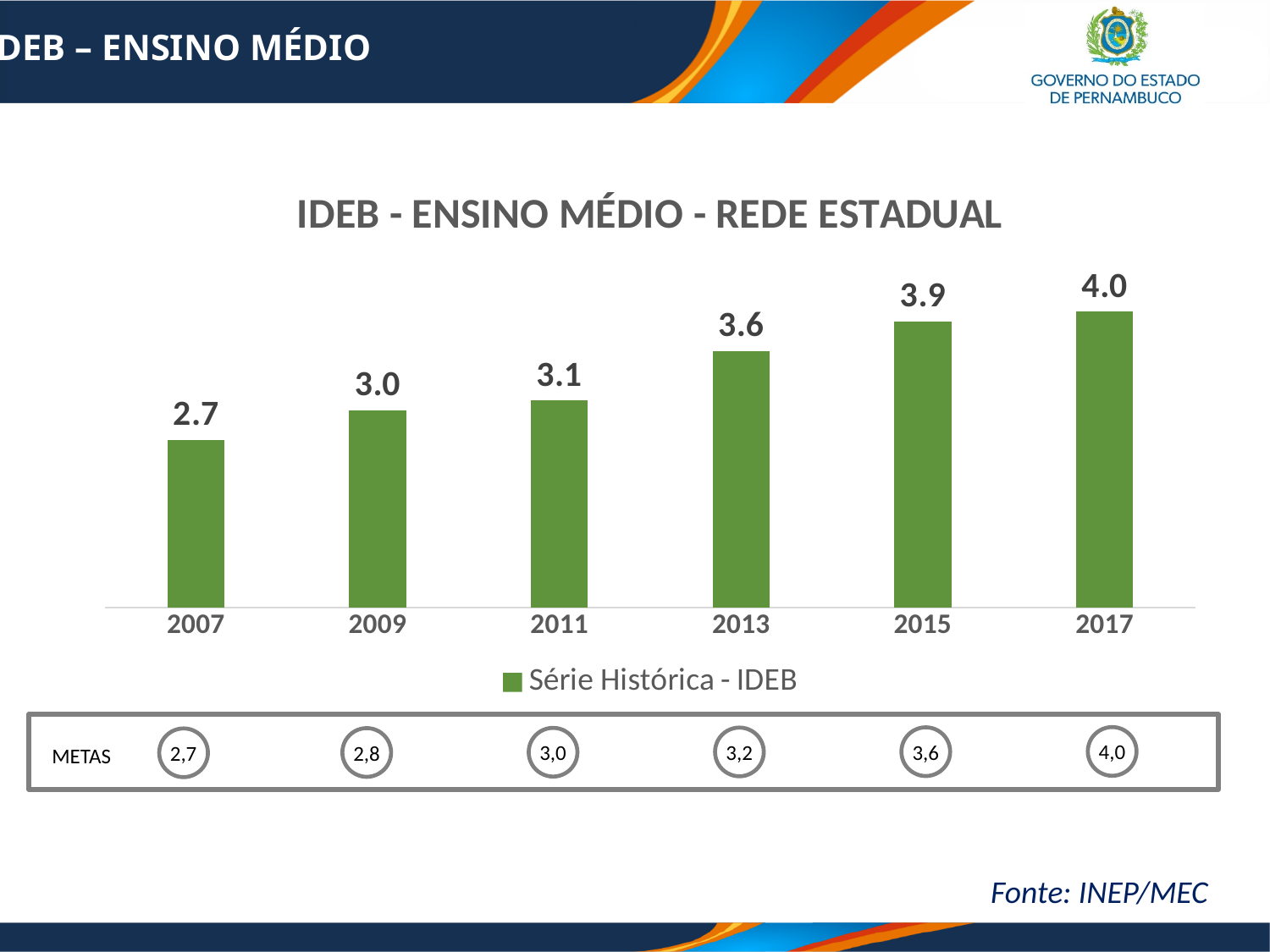
What is the IDEB value for 2013? 3.6 What is the difference between the IDEB values for 2013 and 2011? 0.5 Do the IDEB values rise or fall from 2007 to 2017? Rise What is the difference between the IDEB values for 2017 and 2007? 1.3 Which is larger, the IDEB value for 2009 or for 2015? 2015 What is the IDEB value for 2017? 4.0 What kind of chart is shown on the slide? Bar chart Which year has the lowest IDEB value? 2007 Which year has the highest IDEB value? 2017 What is the IDEB value for 2007? 2.7 How many series does the legend list? 1 How many years are shown on the x axis of the chart? 6